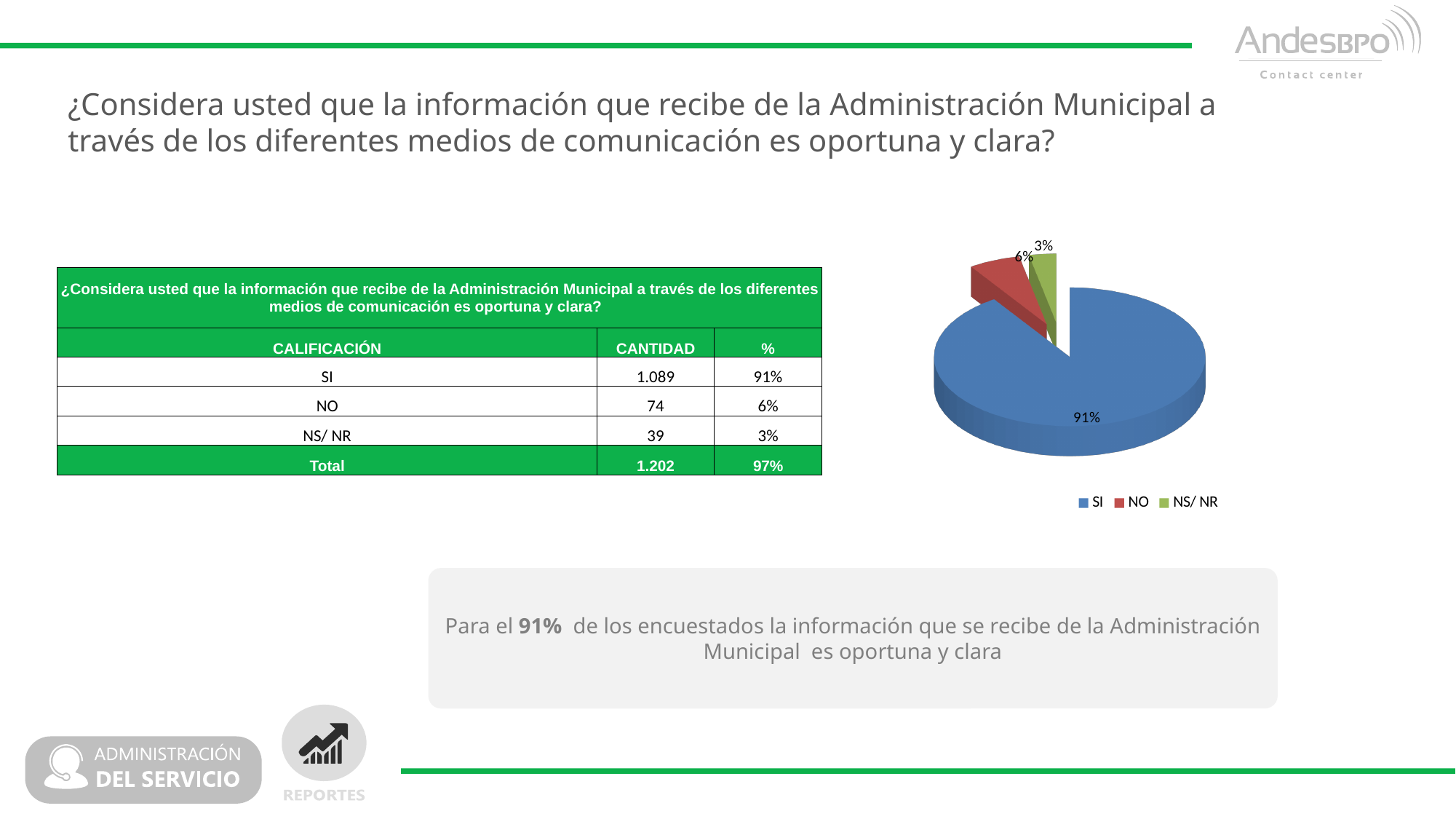
Which category has the smallest slice of the pie? NS/ NR What kind of chart is shown on the slide? pie chart Which category has the largest slice of the pie? SI What share of the pie does the NO slice represent? 6% How many entries does the legend list? 3 What share of the pie does the SI slice represent? 91% What share of the pie does the NS/ NR slice represent? 3% What colour is the NO slice in the pie chart? red Which slice is larger, NO or NS/ NR? NO What colour is the SI slice in the pie chart? blue How many slices does the pie chart have? 3 What is the difference in percentage points between the SI slice and the NO slice? 85